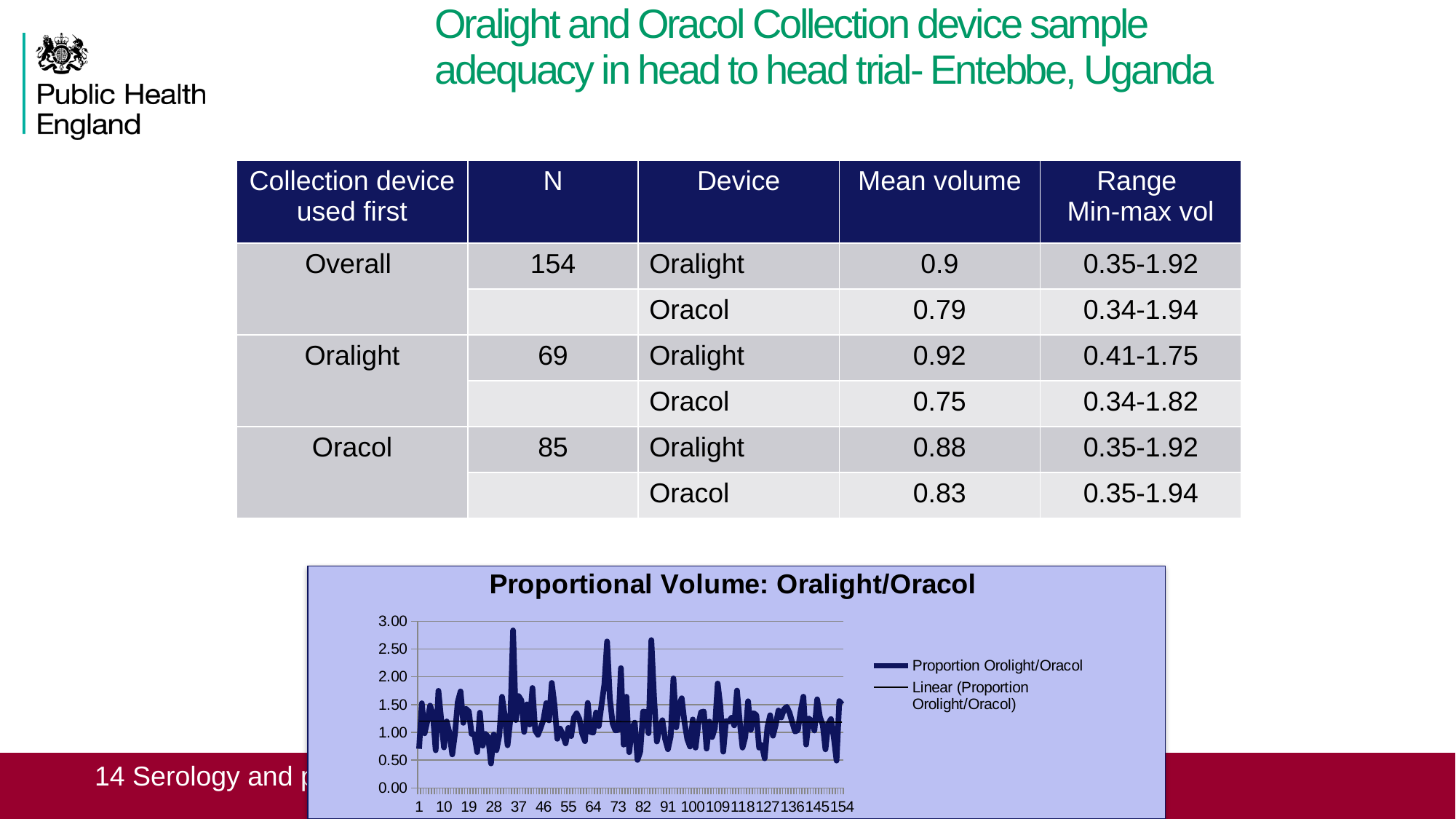
How many series does the chart's legend list? 2 Is the linear trend line on the chart greater or less than 1.50? less What is the last label shown on the chart's x axis? 154 What is the first entry in the chart's legend? Proportion Orolight/Oracol Is the highest peak of the Proportion Orolight/Oracol line greater or less than 2.50? greater What is the first label shown on the chart's x axis? 1 What is the title of the chart? Proportional Volume: Oralight/Oracol Is the lowest point of the Proportion Orolight/Oracol line greater or less than 0.50? less What is the interval between tick labels on the chart's y axis? 0.50 What is the highest value shown on the chart's y axis? 3.00 What type of chart is shown at the bottom of the slide? line chart